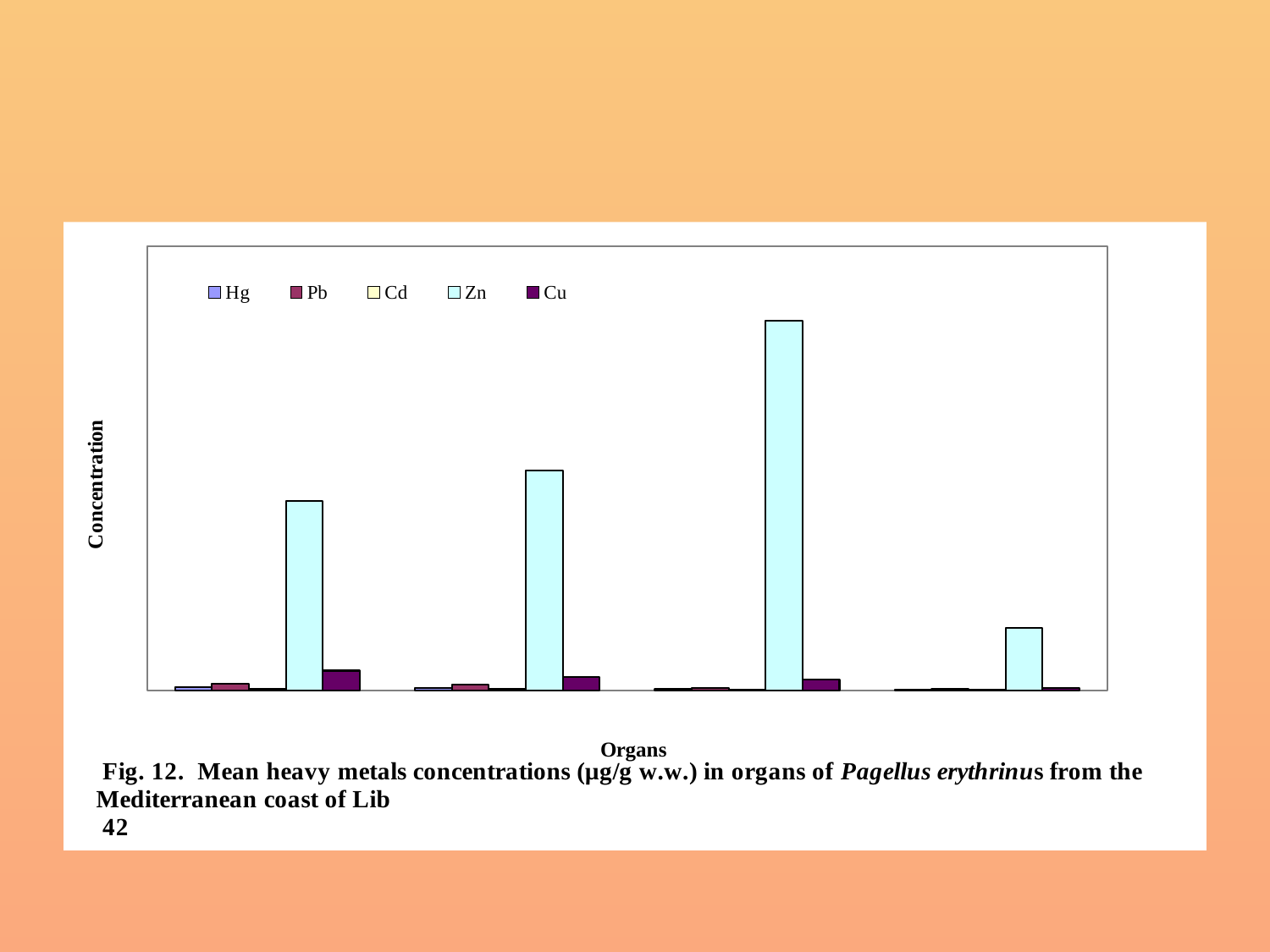
How many groups of bars (organs) are plotted on the x axis? 4 Which is larger, the Zn bar in the third group from the left or the Zn bar in the second group? the third group Does the Zn bar rise or fall from the third group to the fourth group along the x axis? fall In which organ group (counting from the left) is the Zn bar the highest? the third group What kind of chart is shown on the slide? bar chart In which organ group (counting from the left) is the Zn bar the lowest? the fourth group Which metal has the tallest bar in every organ group? Zn In the first group from the left, which is larger, the Zn bar or the Cu bar? Zn Does the Zn bar rise or fall from the first group to the second group along the x axis? rise How many series does the legend list? 5 What is the title of the vertical axis? Concentration Which metals are listed in the chart legend? Hg, Pb, Cd, Zn, Cu